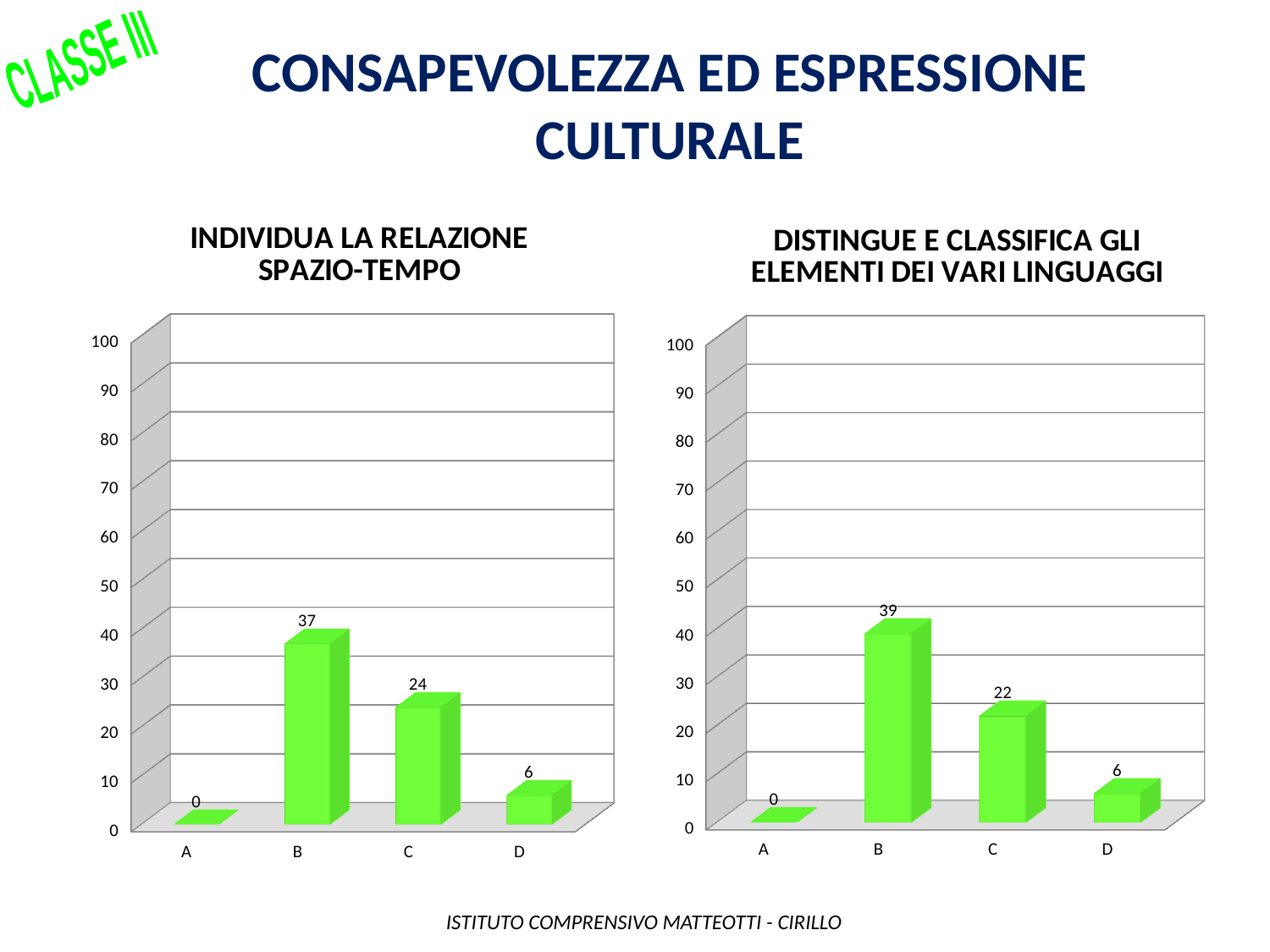
What kind of chart is the chart titled "DISTINGUE E CLASSIFICA GLI ELEMENTI DEI VARI LINGUAGGI"? Bar chart How many categories are shown on the x axis of the chart titled "INDIVIDUA LA RELAZIONE SPAZIO-TEMPO"? 4 In the chart titled "INDIVIDUA LA RELAZIONE SPAZIO-TEMPO", which category has the highest value? B In the chart titled "INDIVIDUA LA RELAZIONE SPAZIO-TEMPO", what is the value for category C? 24 In the chart titled "DISTINGUE E CLASSIFICA GLI ELEMENTI DEI VARI LINGUAGGI", which is larger, the value for C or the value for D? C In the chart titled "DISTINGUE E CLASSIFICA GLI ELEMENTI DEI VARI LINGUAGGI", what is the difference between the values for B and C? 17 In the chart titled "INDIVIDUA LA RELAZIONE SPAZIO-TEMPO", what is the value for category B? 37 In the chart titled "INDIVIDUA LA RELAZIONE SPAZIO-TEMPO", what is the difference between the values for B and C? 13 In the chart titled "INDIVIDUA LA RELAZIONE SPAZIO-TEMPO", is the value for B greater or less than 50? less In the chart titled "DISTINGUE E CLASSIFICA GLI ELEMENTI DEI VARI LINGUAGGI", what is the value for category B? 39 In the chart titled "DISTINGUE E CLASSIFICA GLI ELEMENTI DEI VARI LINGUAGGI", what is the value for category D? 6 In the chart titled "DISTINGUE E CLASSIFICA GLI ELEMENTI DEI VARI LINGUAGGI", which category has the lowest value? A